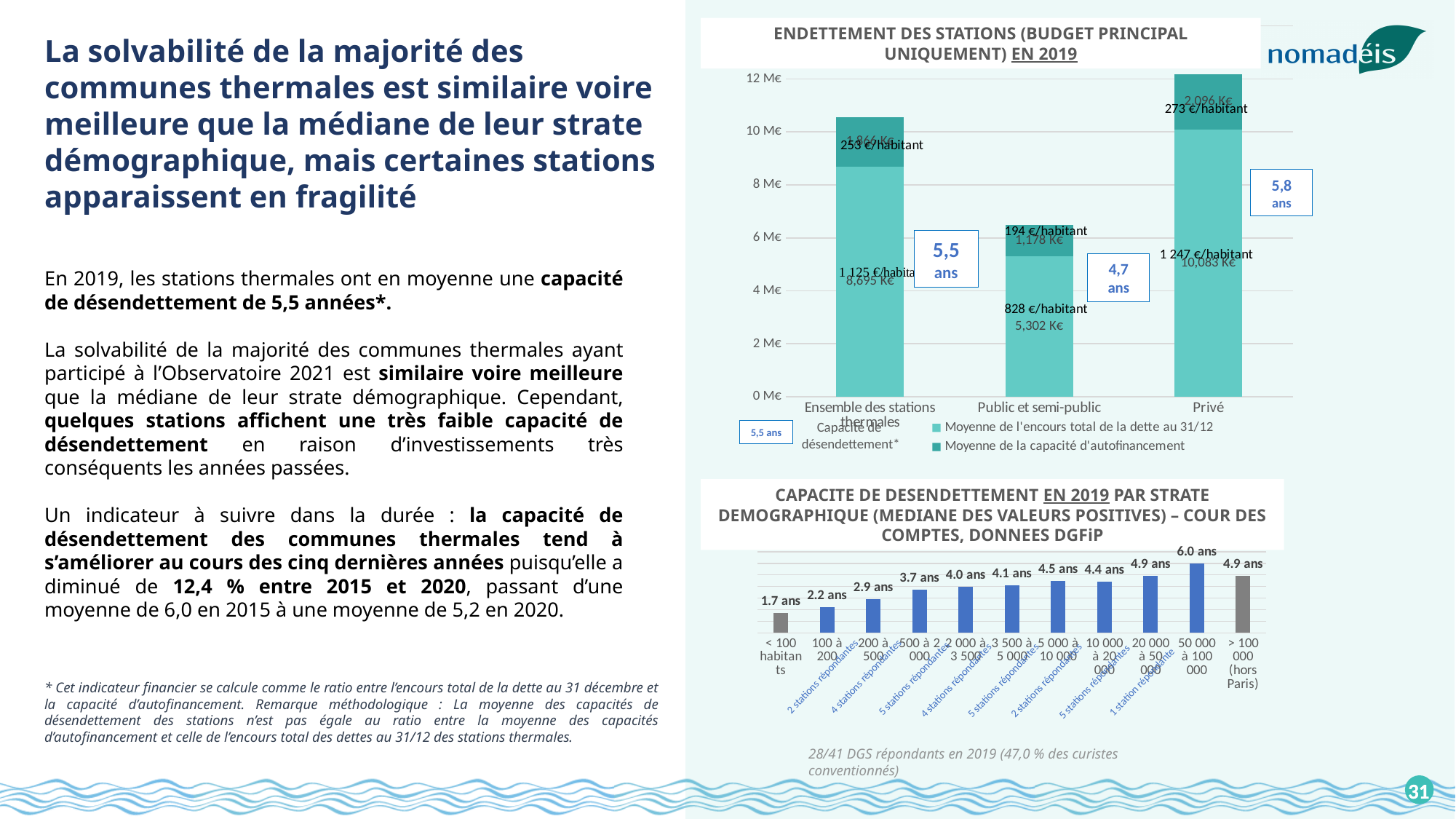
In the chart 'ENDETTEMENT DES STATIONS (BUDGET PRINCIPAL UNIQUEMENT) EN 2019', what is the capacité de désendettement shown for Privé? 5,8 ans In the chart 'CAPACITE DE DESENDETTEMENT EN 2019 PAR STRATE DEMOGRAPHIQUE', what is the difference between the 50 000 à 100 000 stratum and the 20 000 à 50 000 stratum? 1.1 ans In the chart 'ENDETTEMENT DES STATIONS (BUDGET PRINCIPAL UNIQUEMENT) EN 2019', is the total of the Privé bar greater or less than 10 M€? greater What kind of chart is 'CAPACITE DE DESENDETTEMENT EN 2019 PAR STRATE DEMOGRAPHIQUE'? Bar chart In the chart 'CAPACITE DE DESENDETTEMENT EN 2019 PAR STRATE DEMOGRAPHIQUE', how many population strata are plotted? 11 In the chart 'ENDETTEMENT DES STATIONS (BUDGET PRINCIPAL UNIQUEMENT) EN 2019', what is the capacité de désendettement shown for Public et semi-public? 4,7 ans In the chart 'CAPACITE DE DESENDETTEMENT EN 2019 PAR STRATE DEMOGRAPHIQUE', which population stratum has the highest value? 50 000 à 100 000 In the chart 'CAPACITE DE DESENDETTEMENT EN 2019 PAR STRATE DEMOGRAPHIQUE', which is larger: the value for 5 000 à 10 000 or for 10 000 à 20 000? 5 000 à 10 000 In the chart 'CAPACITE DE DESENDETTEMENT EN 2019 PAR STRATE DEMOGRAPHIQUE', what is the value for the 50 000 à 100 000 stratum? 6.0 ans In the chart 'CAPACITE DE DESENDETTEMENT EN 2019 PAR STRATE DEMOGRAPHIQUE', what is the value for the 5 000 à 10 000 stratum? 4.5 ans In the chart 'CAPACITE DE DESENDETTEMENT EN 2019 PAR STRATE DEMOGRAPHIQUE', which population stratum has the lowest value? < 100 habitants How many series does the legend of the chart 'ENDETTEMENT DES STATIONS (BUDGET PRINCIPAL UNIQUEMENT) EN 2019' list? 2